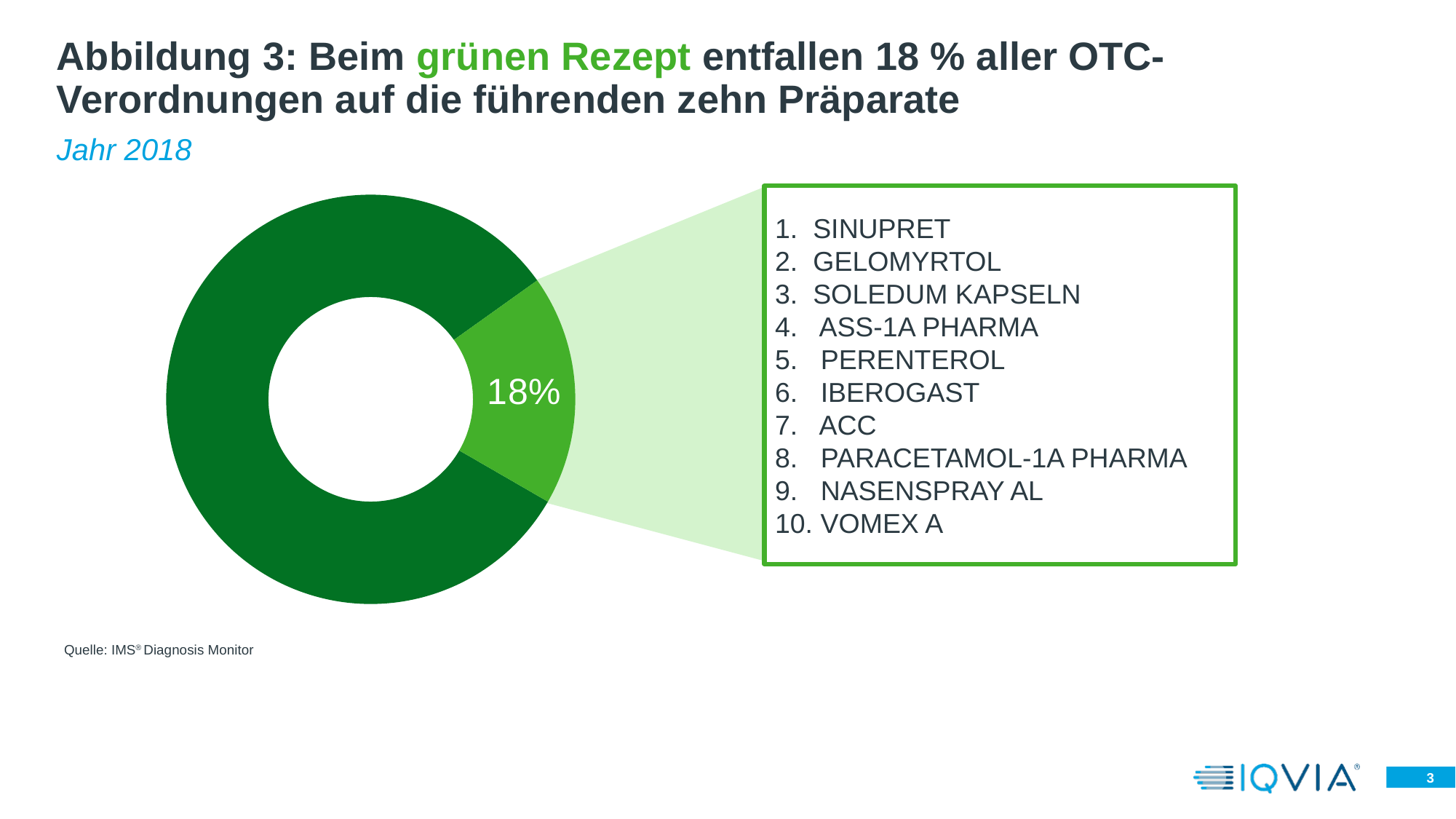
How many preparations are listed in the box connected to the 18% slice? 10 What value is printed on the light green slice of the donut chart? 18% Which preparation is ranked tenth in the list connected to the 18% slice? VOMEX A What source is given for the chart? IMS Diagnosis Monitor Which slice of the donut chart is larger, the dark green slice or the light green slice labelled 18%? The dark green slice Is the share of the dark green slice greater or less than 50%? greater Is the share of the light green slice greater or less than 25%? less Which year does the chart refer to? 2018 What share of all OTC prescriptions on the green prescription is attributed to the leading ten preparations, according to the chart? 18% How many slices does the donut chart have? 2 What kind of chart is shown on the slide? Pie chart (donut) Which preparation is ranked first in the list connected to the 18% slice? SINUPRET